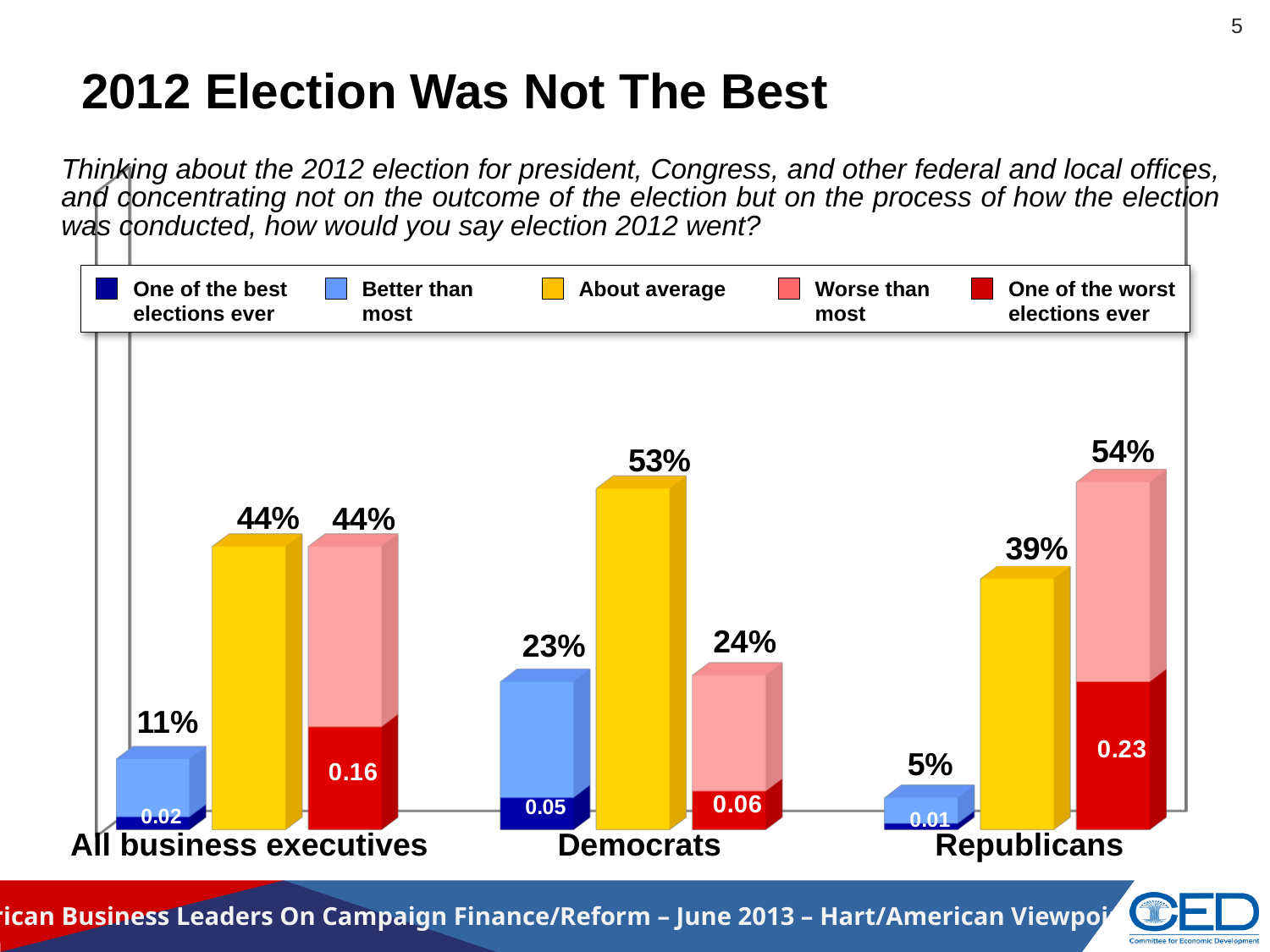
What value is printed on the 'One of the worst elections ever' segment for Republicans? 0.23 What is the difference between the 'About average' values for Democrats and Republicans? 14 percentage points How many groups are shown on the x axis? 3 What is the 'About average' value for Republicans? 39% What value is printed on the 'One of the best elections ever' segment for Democrats? 0.05 How many series does the legend list? 5 What is the total labelled on the stacked 'Worse than most' / 'One of the worst elections ever' bar for All business executives? 44% What is the 'About average' value for Democrats? 53% Which group has the highest 'About average' value? Democrats Which group has the lowest total on the stacked 'One of the best' / 'Better than most' bar? Republicans Which is larger: the stacked 'Worse than most' / 'One of the worst' total for Republicans or for Democrats? Republicans What type of chart is shown on the slide? Bar chart